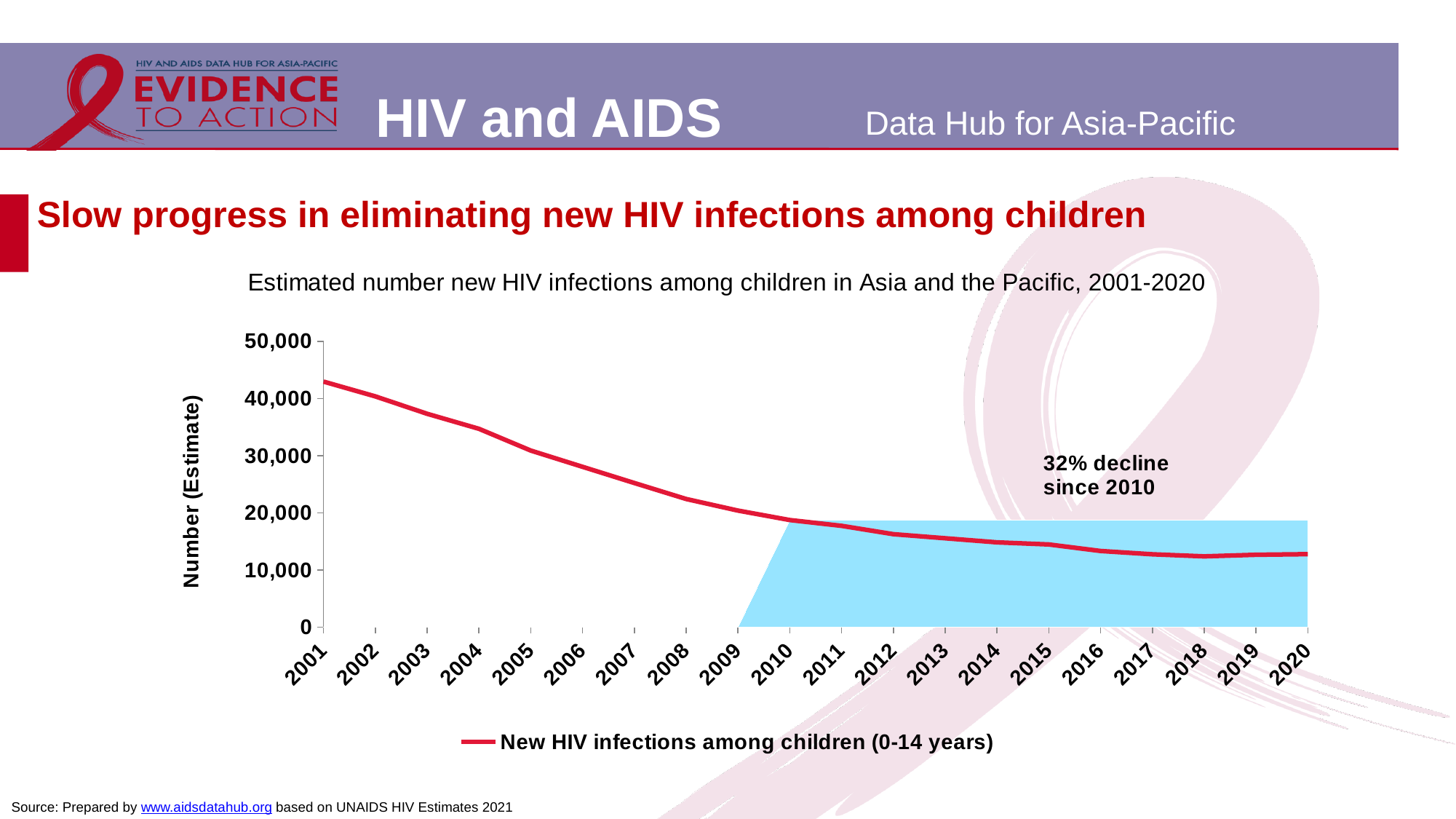
Is the value for 2001 greater or less than 40,000? greater Is the value for 2010 greater or less than 30,000? less What series name is shown in the chart legend? New HIV infections among children (0-14 years) How many series does the chart legend list? 1 Do the estimated new HIV infections among children rise or fall from 2001 to 2020? fall Is the value for 2005 greater or less than 20,000? greater Which year has the larger value, 2001 or 2020? 2001 How many years are plotted along the x axis of the chart? 20 What kind of chart is shown on the slide? line chart What percentage decline since 2010 is annotated on the chart? 32% Which year has the highest estimated number of new HIV infections among children? 2001